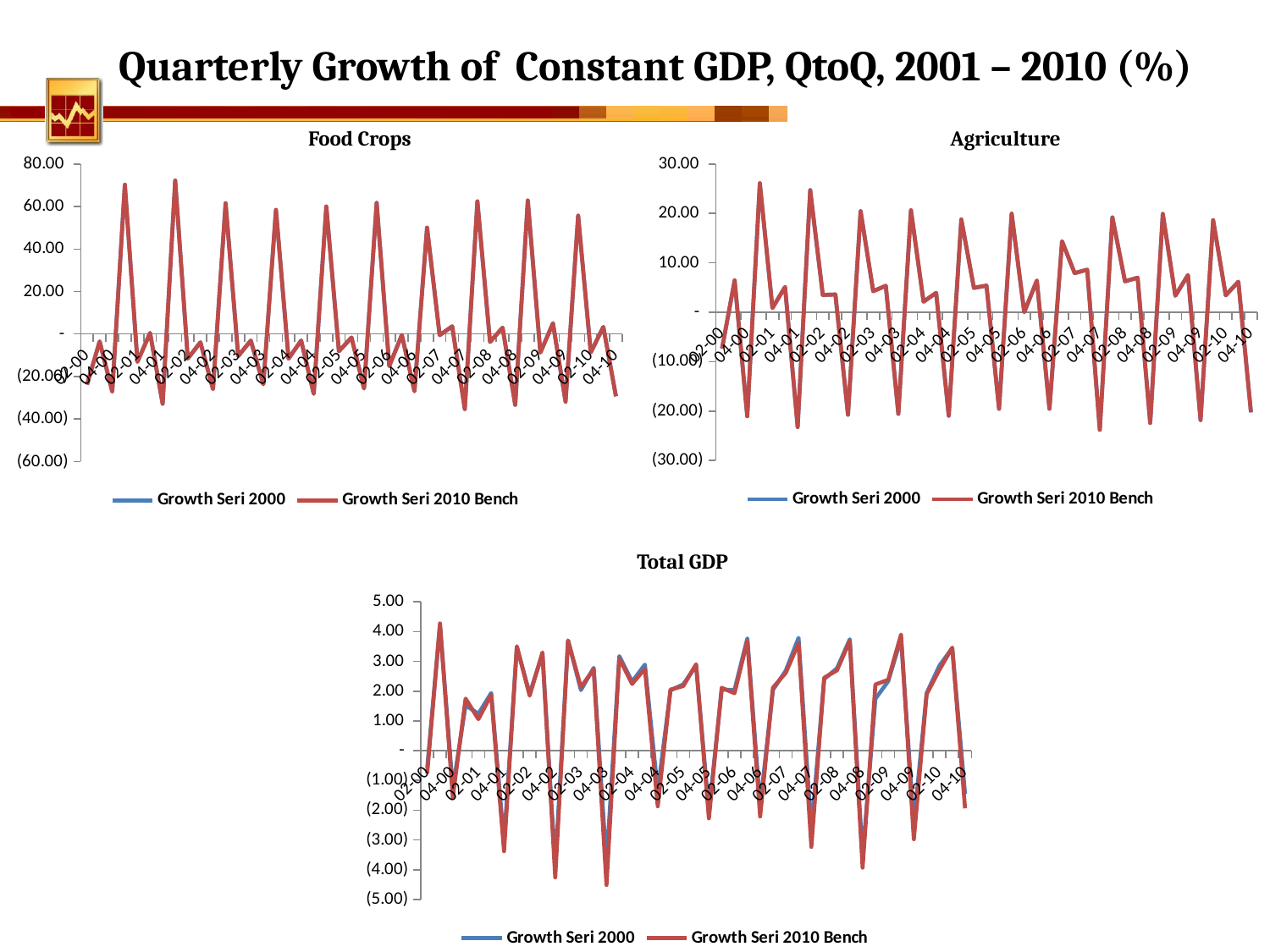
On the Agriculture chart, is the lowest value of Growth Seri 2010 Bench greater or less than (20.00)? less What kind of chart is the Food Crops chart? line chart What are the two series named in the legend of the Food Crops chart? Growth Seri 2000 and Growth Seri 2010 Bench What kind of chart is the Total GDP chart? line chart How many series does the legend of the Total GDP chart list? 2 What is the title of the chart at the bottom of the slide? Total GDP On the Agriculture chart, is the highest value of Growth Seri 2010 Bench greater or less than 20? greater On the Food Crops chart, is the lowest value of Growth Seri 2010 Bench greater or less than (20.00)? less How many series does the legend of the Agriculture chart list? 2